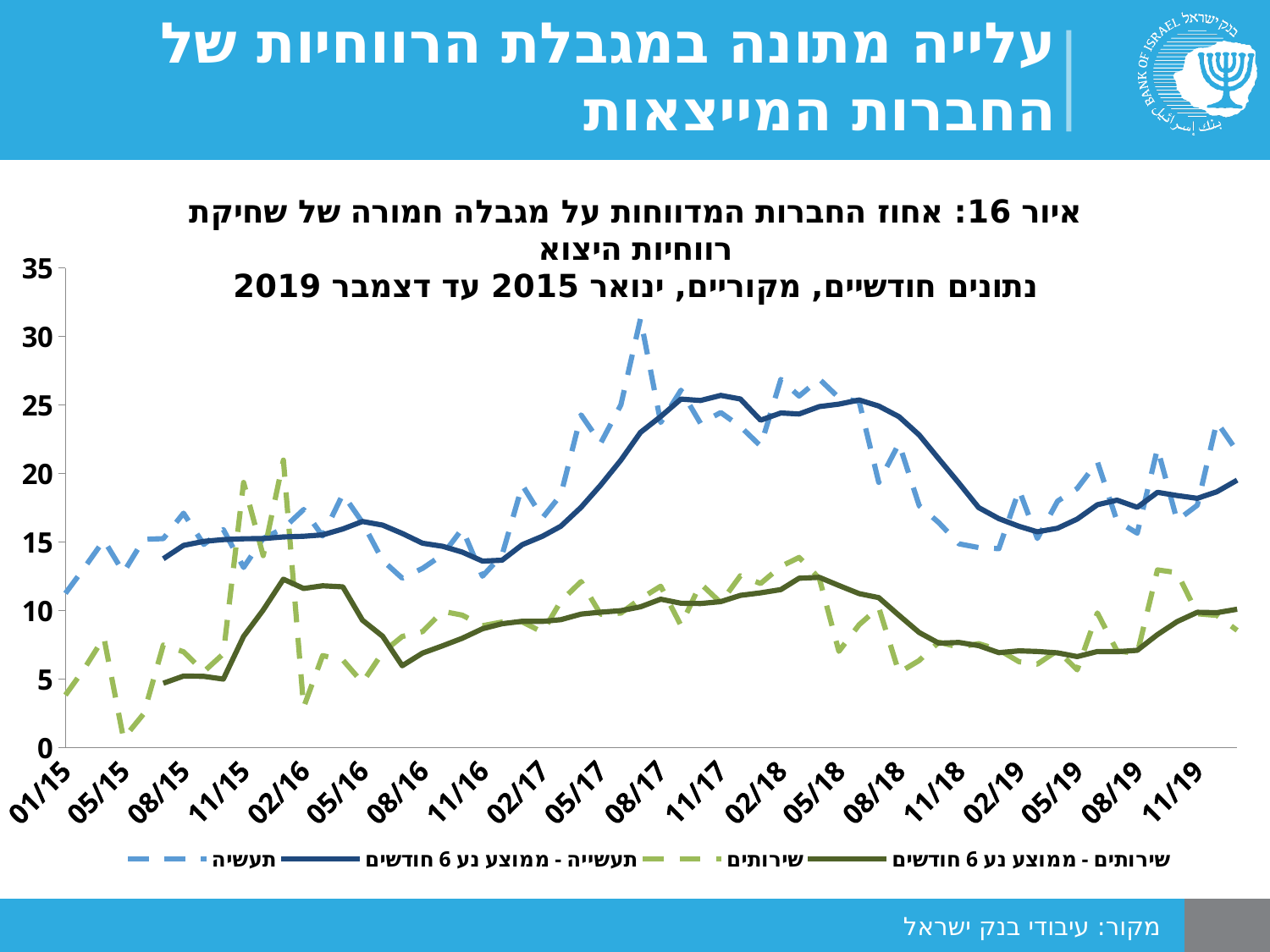
What is the title of the chart (first line)? איור 16: אחוז החברות המדווחות על מגבלה חמורה של שחיקת רווחיות היצוא Does the שירותים - ממוצע נע 6 חודשים series rise or fall between 05/18 and 11/18? fall Does the תעשייה - ממוצע נע 6 חודשים series rise or fall between 11/16 and 08/17? rise Is the value of the שירותים series at 05/15 greater or less than 5? less At 08/17, which is larger: the תעשייה - ממוצע נע 6 חודשים series or the שירותים - ממוצע נע 6 חודשים series? תעשייה - ממוצע נע 6 חודשים Is the value of the תעשייה - ממוצע נע 6 חודשים series at 11/18 greater or less than 20? less Is the value of the תעשייה series at 01/15 greater or less than 10? greater Which period does the chart's subtitle say the monthly data cover? ינואר 2015 עד דצמבר 2019 How many series does the legend list? 4 What kind of chart is shown on the slide? line chart